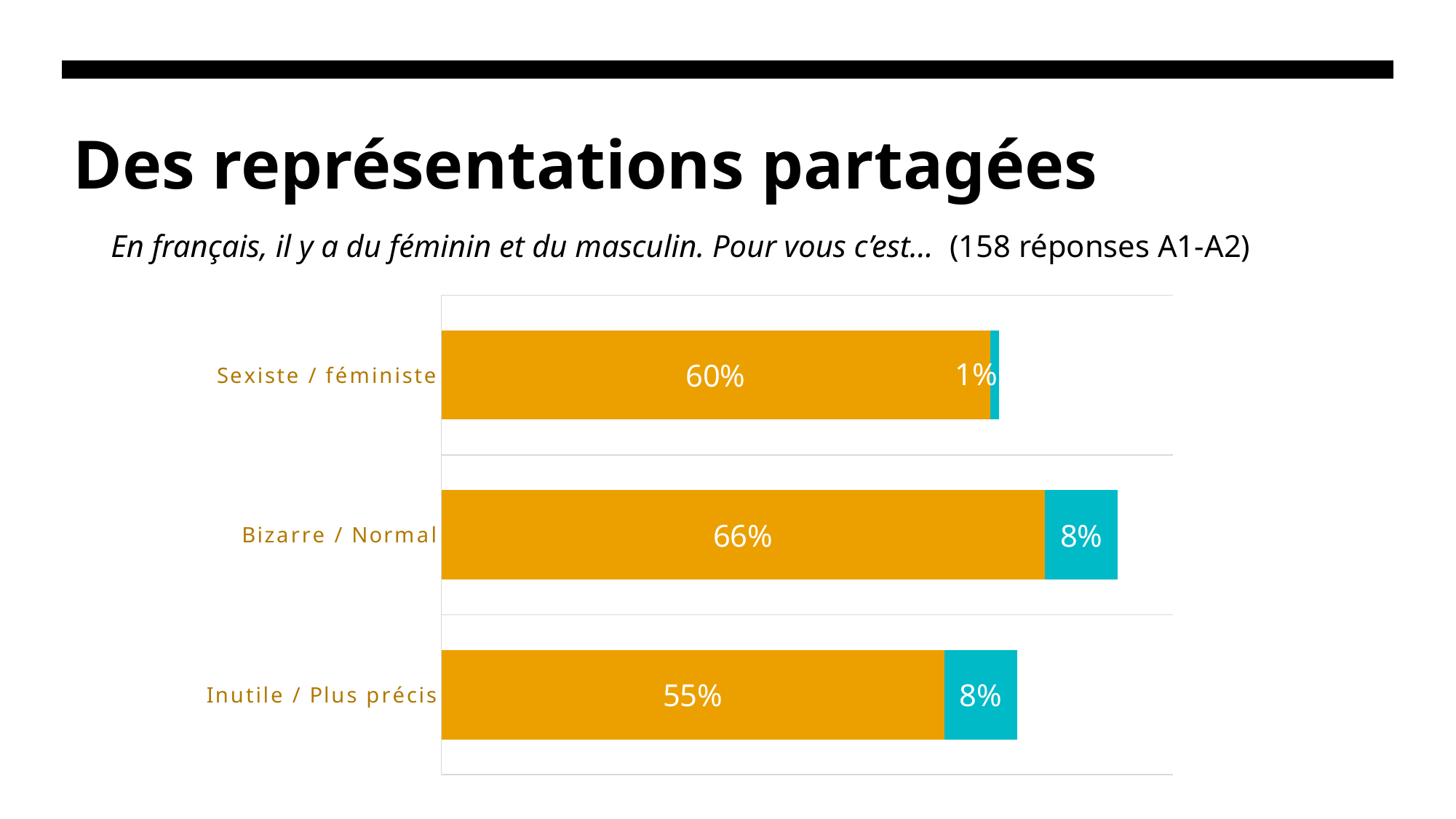
What is the value of the orange segment for Inutile / Plus précis? 55% What kind of chart is shown on the slide? Stacked bar chart What is the total of the stacked bar for Bizarre / Normal? 74% Which is larger, the orange segment for Sexiste / féministe or the orange segment for Bizarre / Normal? Bizarre / Normal What is the value of the teal segment for Sexiste / féministe? 1% What is the value of the orange segment for Bizarre / Normal? 66% Which category has the smallest teal segment value? Sexiste / féministe Which category has the highest orange segment value? Bizarre / Normal What is the difference between the orange segment values for Bizarre / Normal and Inutile / Plus précis? 11% Which category has the lowest orange segment value? Inutile / Plus précis What is the value of the teal segment for Inutile / Plus précis? 8% How many categories are shown in the chart? 3